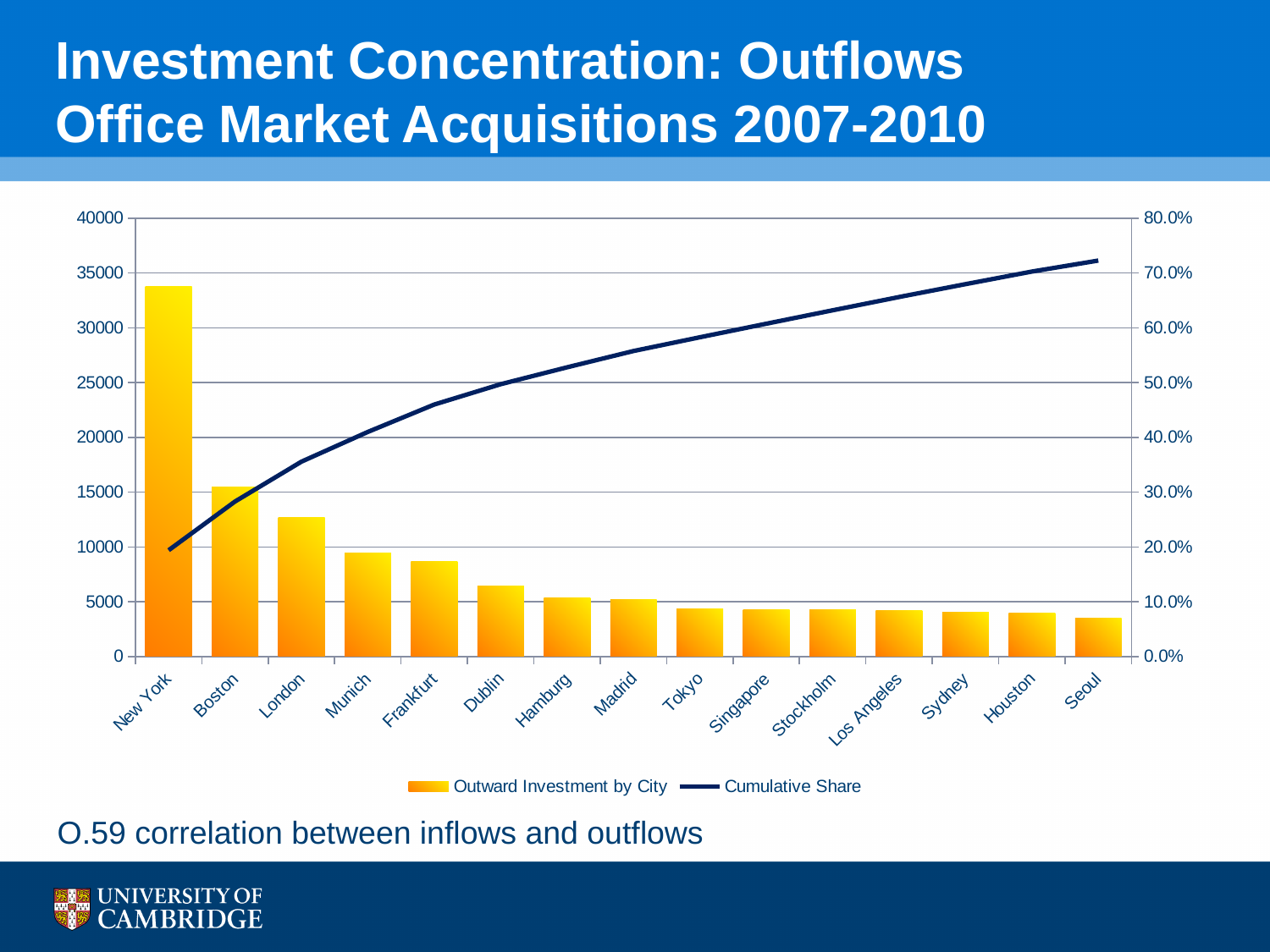
How many series does the legend list? 2 Is the cumulative share at Seoul greater or less than 70.0%? greater How many cities are shown on the x axis? 15 Is the outward investment value for Seoul greater or less than 5000? less Is the outward investment value for London greater or less than 15000? less Do the outward investment bars rise or fall from New York to Seoul? fall Which city has a larger outward investment, Boston or London? Boston What kind of chart is shown on the slide? bar chart with a line Which city has the lowest outward investment? Seoul Which city has the highest outward investment? New York